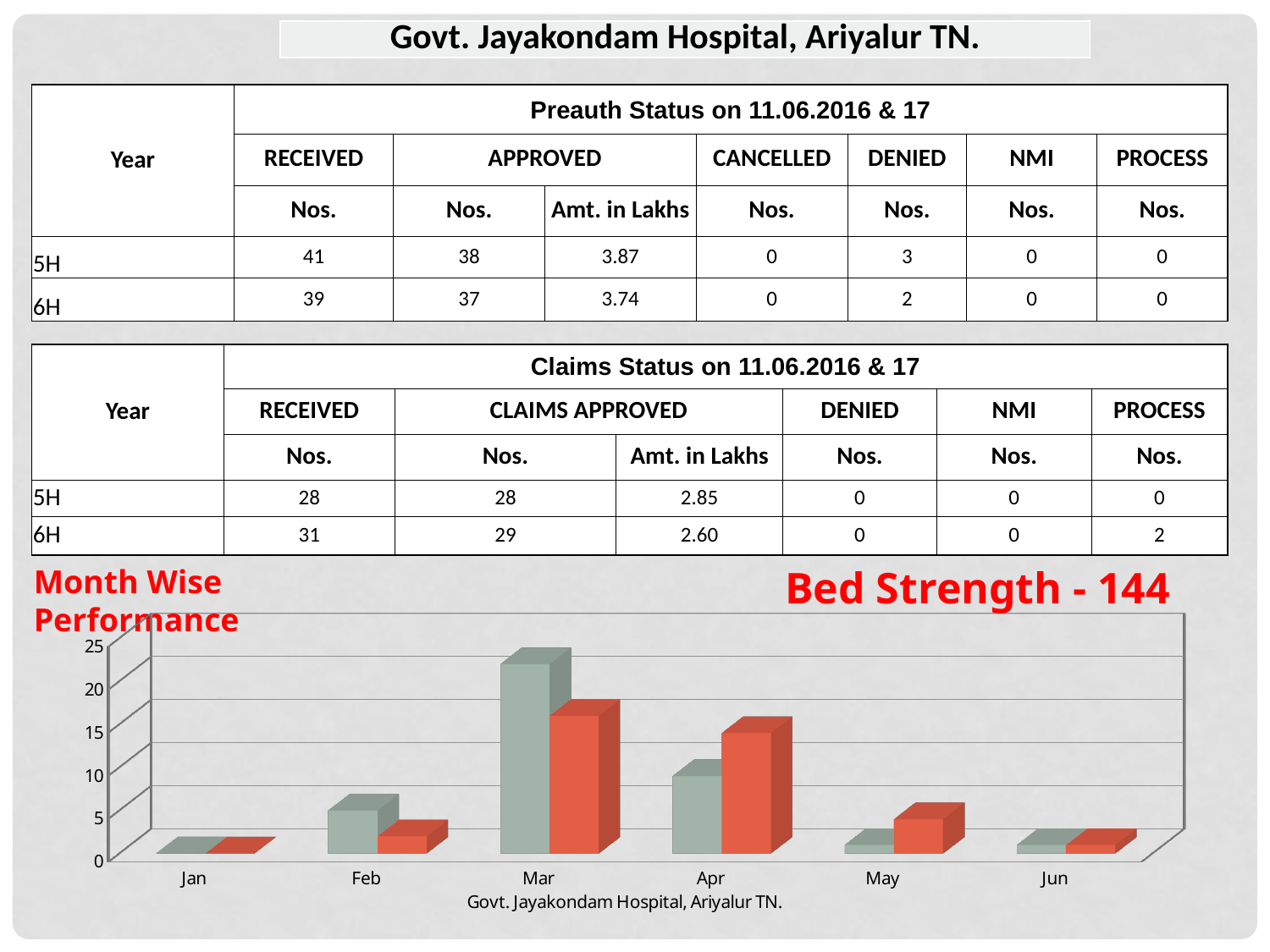
In the Month Wise Performance chart, is the red bar for Mar greater or less than 20? less In the Month Wise Performance chart, is the red bar for Apr greater or less than 10? greater In the Month Wise Performance chart, which is larger for Apr, the grey bar or the red bar? the red bar In the Month Wise Performance chart, which is larger for Feb, the grey bar or the red bar? the grey bar What is the highest value shown on the vertical axis of the Month Wise Performance chart? 25 What text appears below the x axis of the Month Wise Performance chart? Govt. Jayakondam Hospital, Ariyalur TN. In the Month Wise Performance chart, which month has the tallest red bar? Mar In the Month Wise Performance chart, which month has the tallest grey bar? Mar What kind of chart is shown at the bottom of the slide? bar chart In the Month Wise Performance chart, is the grey bar for Mar greater or less than 20? greater How many months are shown on the x axis of the Month Wise Performance chart? 6